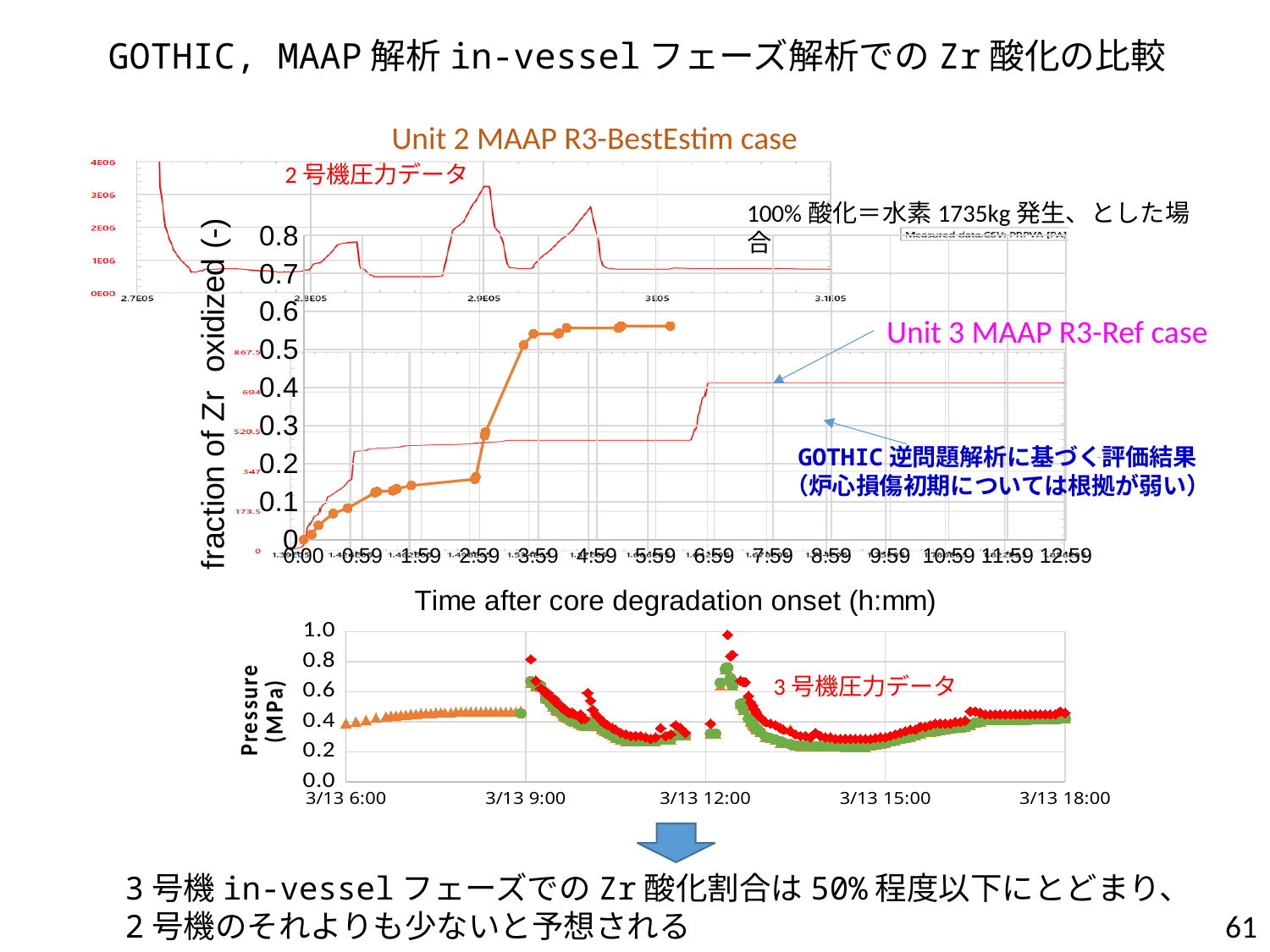
In the main chart, is the final plateau value of the Unit 3 MAAP R3-Ref case greater or less than 0.5? less In the bottom pressure chart, how many time tick labels are shown on the x axis? 5 In the main chart, is the plateau value of the Unit 2 MAAP R3-BestEstim case after 4:59 greater or less than 0.5? greater In the bottom pressure chart, is the peak pressure near 3/13 12:00 greater or less than 0.8 MPa? greater In the main chart, what is the label of the y axis? fraction of Zr oxidized (-) In the main chart, what is the label of the x axis? Time after core degradation onset (h:mm) In the bottom pressure chart, what is the label of the y axis? Pressure (MPa) What kind of chart is the main chart of fraction of Zr oxidized versus time? line chart In the main chart, which series reaches the higher fraction of Zr oxidized at 5:59: Unit 2 MAAP R3-BestEstim case or Unit 3 MAAP R3-Ref case? Unit 2 MAAP R3-BestEstim case In the main chart, does the Unit 2 MAAP R3-BestEstim case rise or fall between 0:00 and 3:59? rise